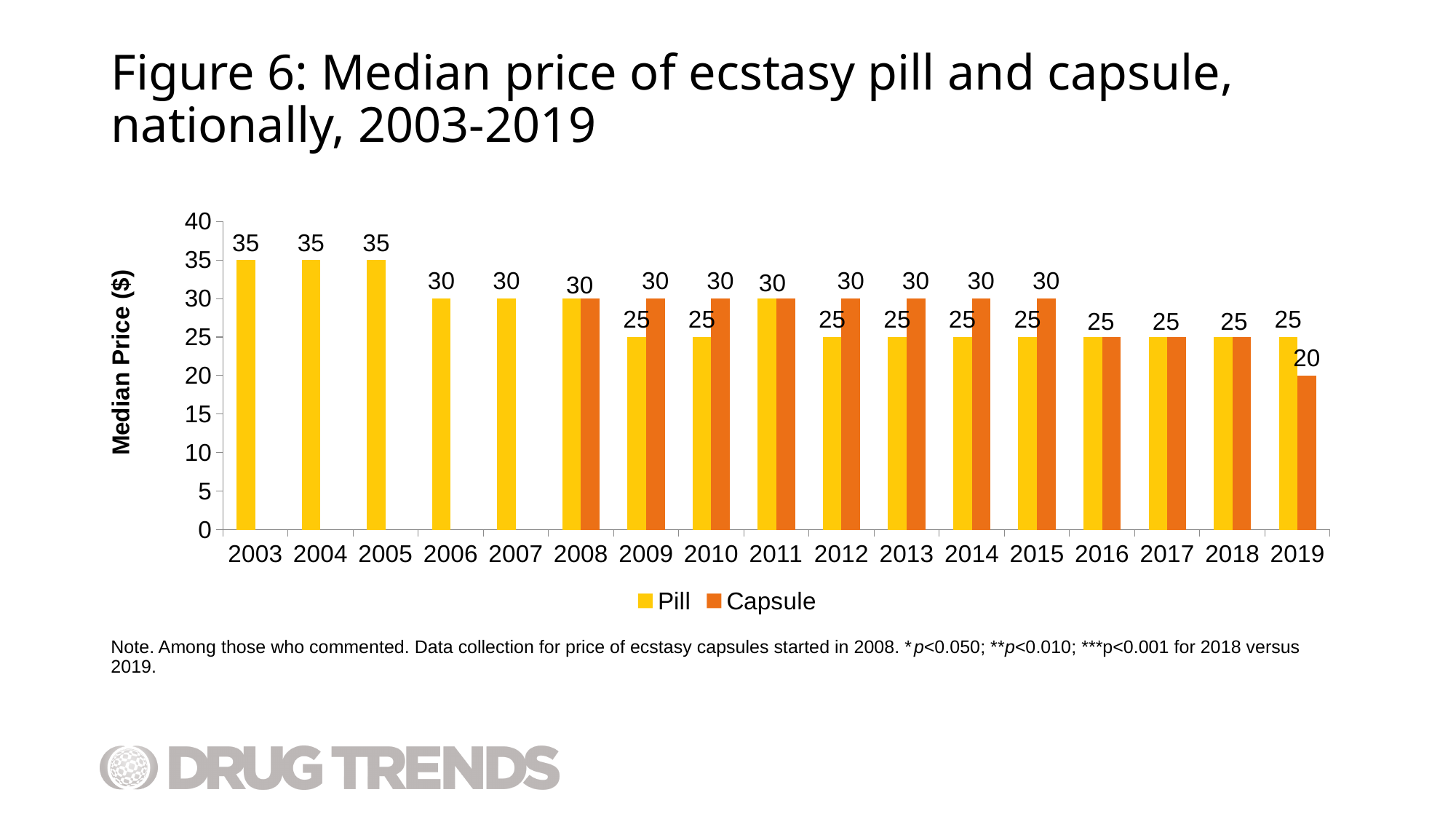
Does the Pill median price rise or fall from 2003 to 2019? Fall How many series does the legend list? 2 What kind of chart is shown on the slide? Bar chart What is the label on the y axis? Median Price ($) In which year is the Capsule median price lowest? 2019 What is the difference between the Pill and Capsule median prices in 2019? 5 What is the median price of a Pill in 2003? 35 How many years are shown on the x axis? 17 What is the median price of a Capsule in 2012? 30 What is the median price of a Capsule in 2019? 20 What is the median price of a Pill in 2009? 25 In 2009, which has the higher median price, Pill or Capsule? Capsule